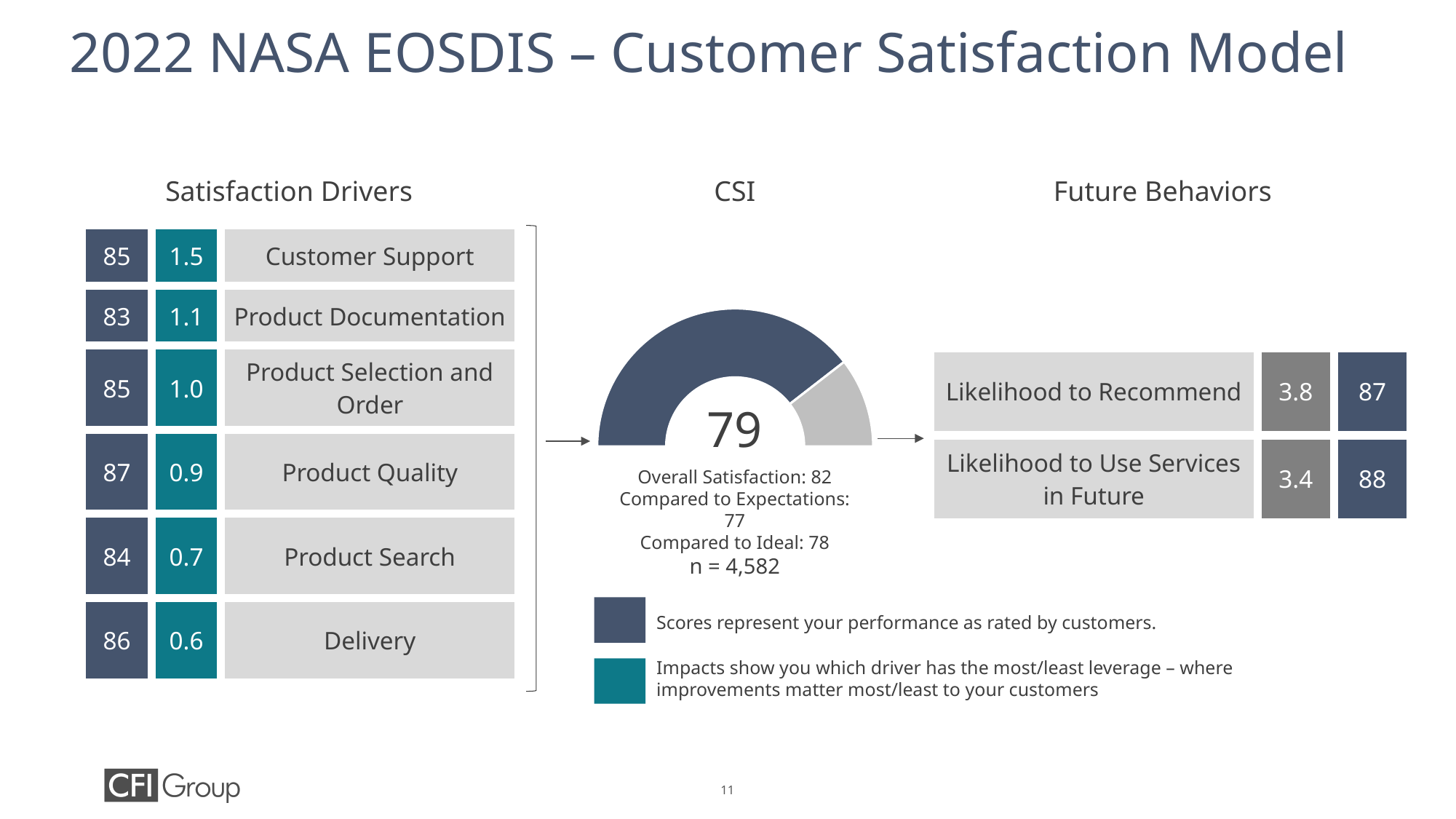
What is the difference between the Overall Satisfaction score and the Compared to Expectations score shown below the gauge? 5 Which satisfaction driver has the highest score in the Satisfaction Drivers section? Product Quality How many satisfaction drivers are listed in the Satisfaction Drivers section? 6 What is the Compared to Expectations score printed below the CSI gauge? 77 Is the CSI value shown on the gauge greater or less than 50? greater Which is larger, the Overall Satisfaction score or the Compared to Ideal score shown below the gauge? Overall Satisfaction What CSI value is shown in the centre of the gauge chart? 79 What is the Overall Satisfaction score printed below the CSI gauge? 82 Which satisfaction driver has the highest impact value in the Satisfaction Drivers section? Customer Support What sample size (n) is printed below the CSI gauge? n = 4,582 What kind of chart is used to display the CSI score on the slide? gauge chart What is the Compared to Ideal score printed below the CSI gauge? 78